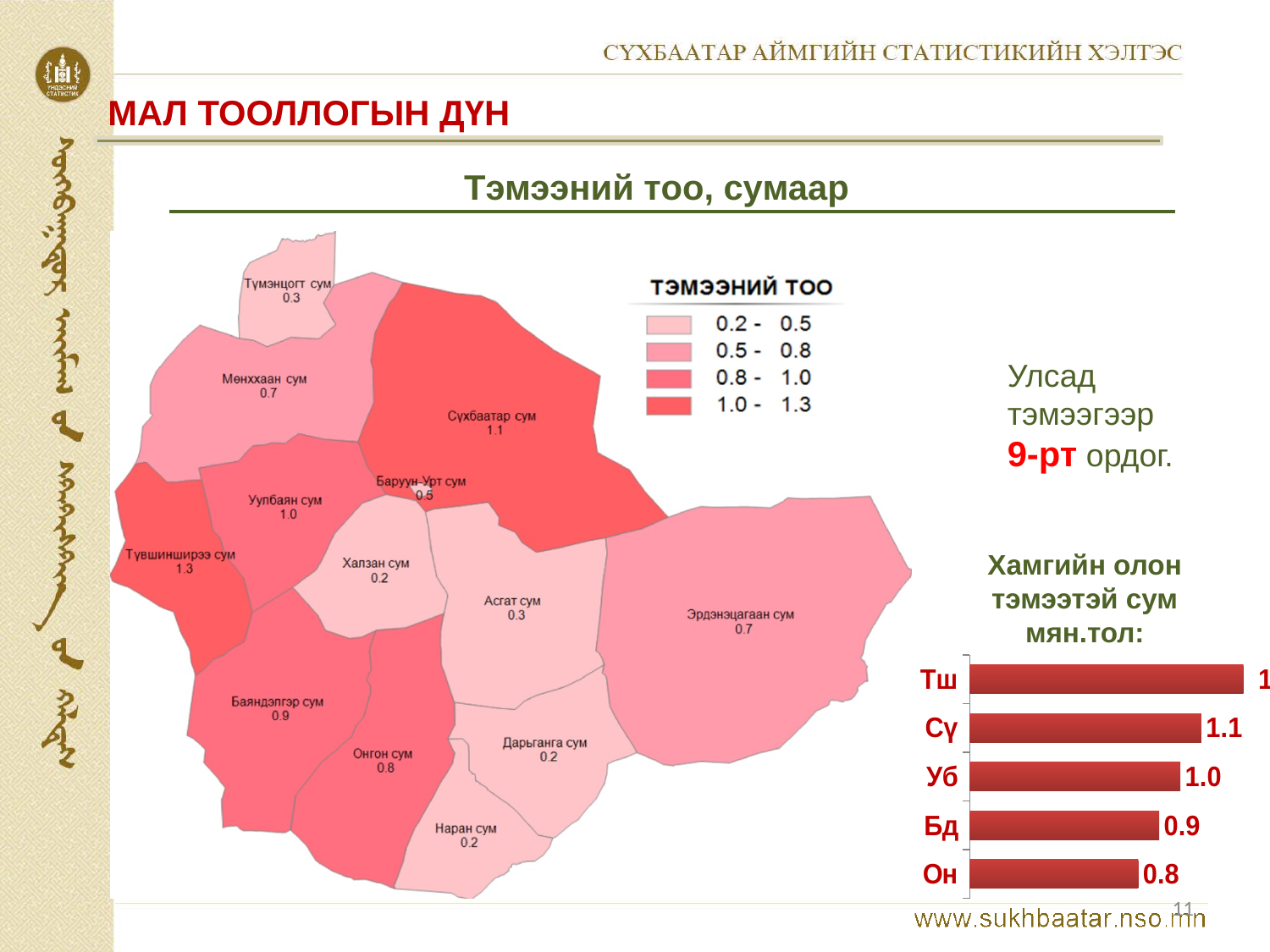
In the bar chart 'Хамгийн олон тэмээтэй сум мян.тол:', which is larger, the value for Уб or the value for Бд? Уб In the bar chart 'Хамгийн олон тэмээтэй сум мян.тол:', how many categories are shown? 5 In the bar chart 'Хамгийн олон тэмээтэй сум мян.тол:', which category has the lowest value? Он In the bar chart 'Хамгийн олон тэмээтэй сум мян.тол:', do the values rise or fall going from the top bar to the bottom bar? fall In the bar chart 'Хамгийн олон тэмээтэй сум мян.тол:', what is the value for Он? 0.8 In the bar chart 'Хамгийн олон тэмээтэй сум мян.тол:', what is the value for Сү? 1.1 On the map 'Тэмээний тоо, сумаар', what value is printed for Түвшинширээ сум? 1.3 In the bar chart 'Хамгийн олон тэмээтэй сум мян.тол:', what is the value for Уб? 1.0 What kind of chart is shown under the heading 'Хамгийн олон тэмээтэй сум мян.тол:'? bar chart In the bar chart 'Хамгийн олон тэмээтэй сум мян.тол:', what is the difference between the values for Сү and Он? 0.3 In the bar chart 'Хамгийн олон тэмээтэй сум мян.тол:', what is the value for Бд? 0.9 In the bar chart 'Хамгийн олон тэмээтэй сум мян.тол:', which category has the longest bar? Тш